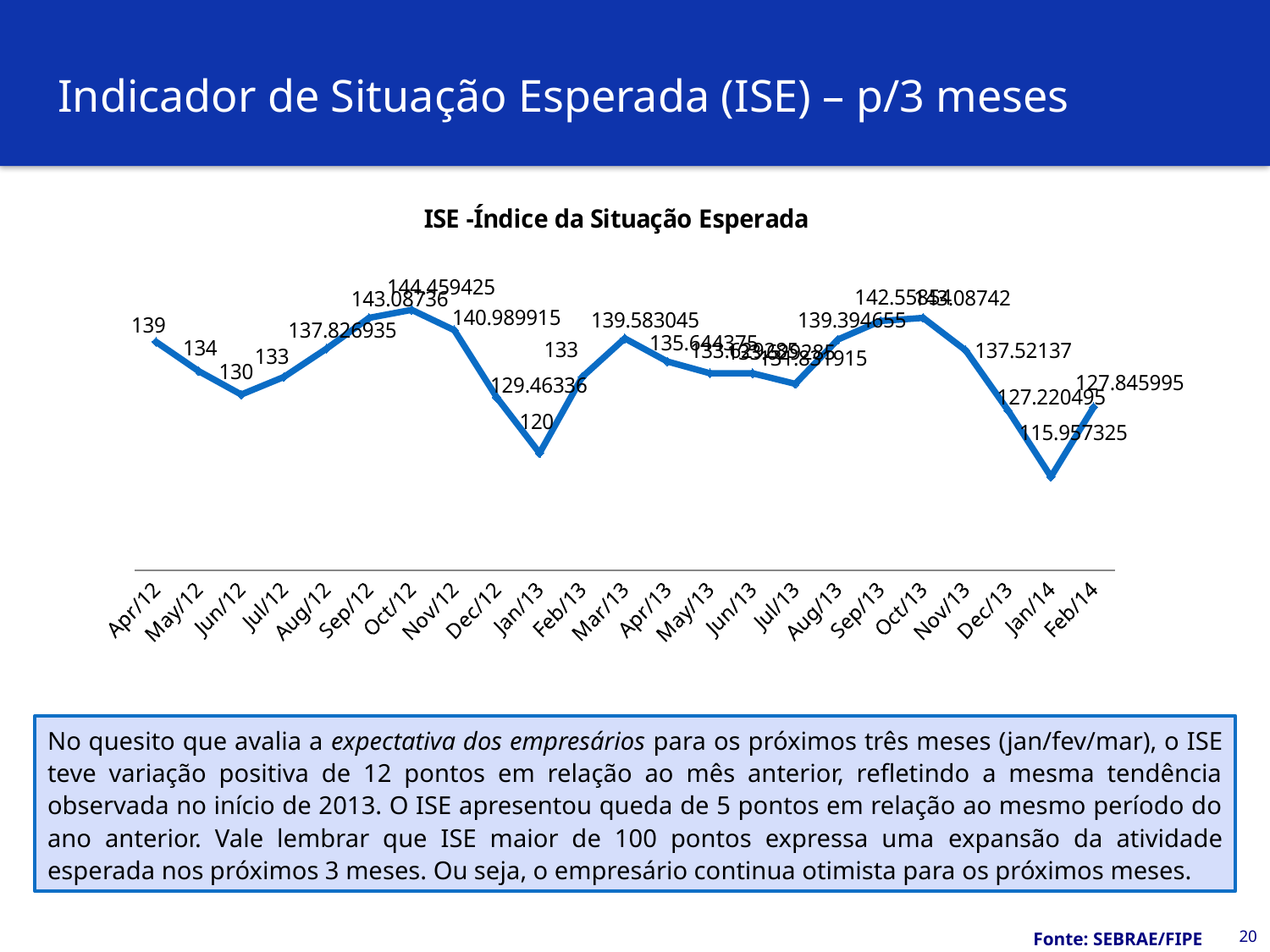
What is the difference between the values for Feb/13 and Jan/13? 13 What is the value for Feb/14? 127.845995 What is the difference between the values for Apr/12 and Jun/12? 9 Which is larger, the value for Oct/12 or the value for Jan/13? Oct/12 Which month has the highest value? Oct/12 What kind of chart is shown? line chart What is the value for Oct/12? 144.459425 Which month has the lowest value? Jan/14 What is the value for Nov/13? 137.52137 How many months are plotted on the chart? 23 What is the value for Jan/14? 115.957325 What is the value for Apr/12? 139